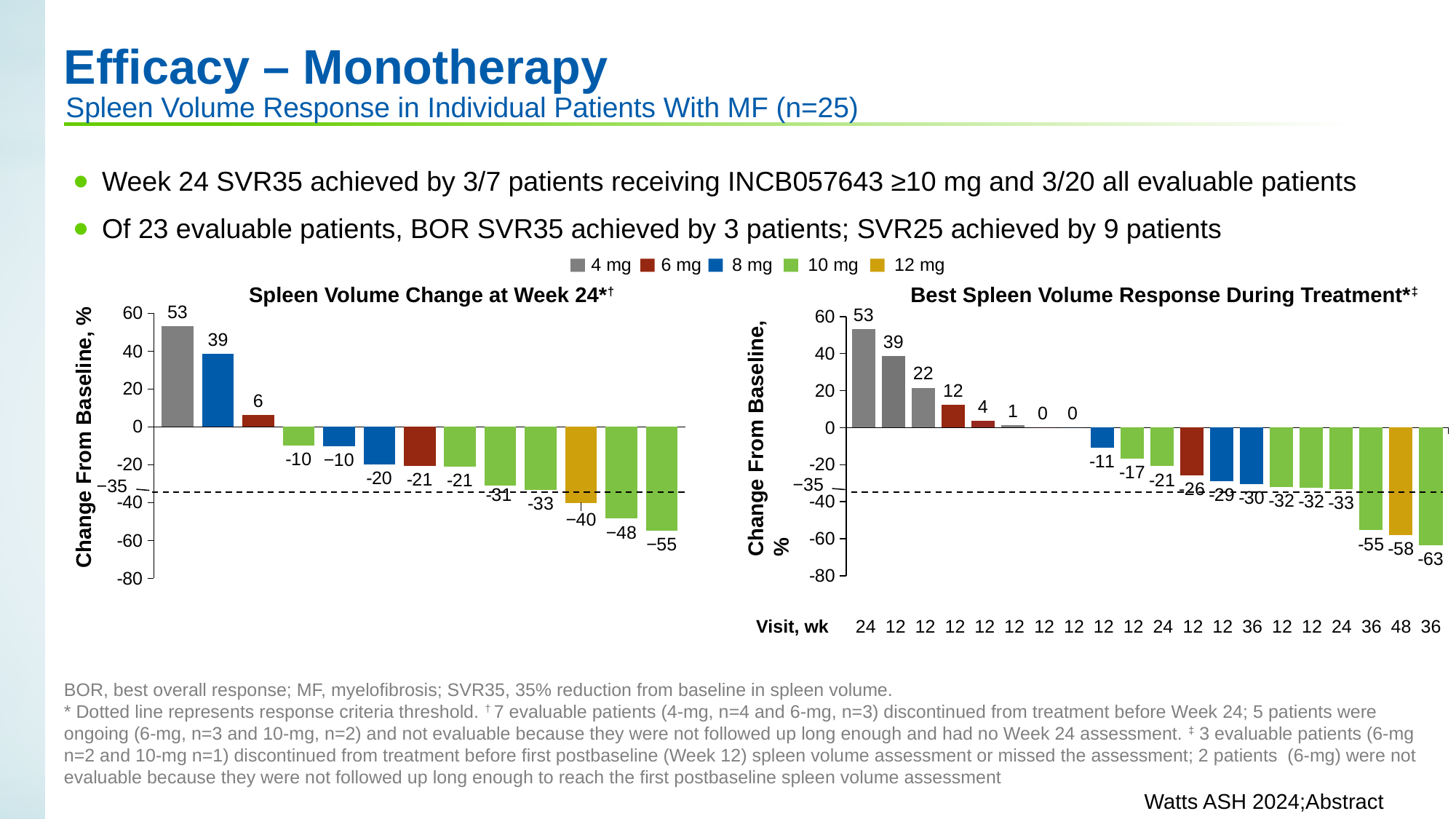
In the 'Spleen Volume Change at Week 24' chart, what is the difference between the highest value (53) and the second bar (39)? 14 In the 'Spleen Volume Change at Week 24' chart, what is the lowest value shown? -55 In the 'Spleen Volume Change at Week 24' chart, what is the highest value shown? 53 In the 'Spleen Volume Change at Week 24' chart, what is the value of the single 12 mg (gold) bar? -40 In the 'Best Spleen Volume Response During Treatment' chart, how many patient bars are plotted? 20 In the 'Best Spleen Volume Response During Treatment' chart, what is the lowest value shown? -63 In the 'Best Spleen Volume Response During Treatment' chart, what is the value of the 6 mg (red) bar that falls below zero? -26 In the 'Best Spleen Volume Response During Treatment' chart, what is the value of the 12 mg (gold) bar? -58 What kind of chart is the 'Spleen Volume Change at Week 24' chart on the left? bar chart How many dose groups does the legend list? 5 What value does the dotted horizontal line mark on both charts? -35 In the 'Spleen Volume Change at Week 24' chart, how many patient bars are plotted? 13